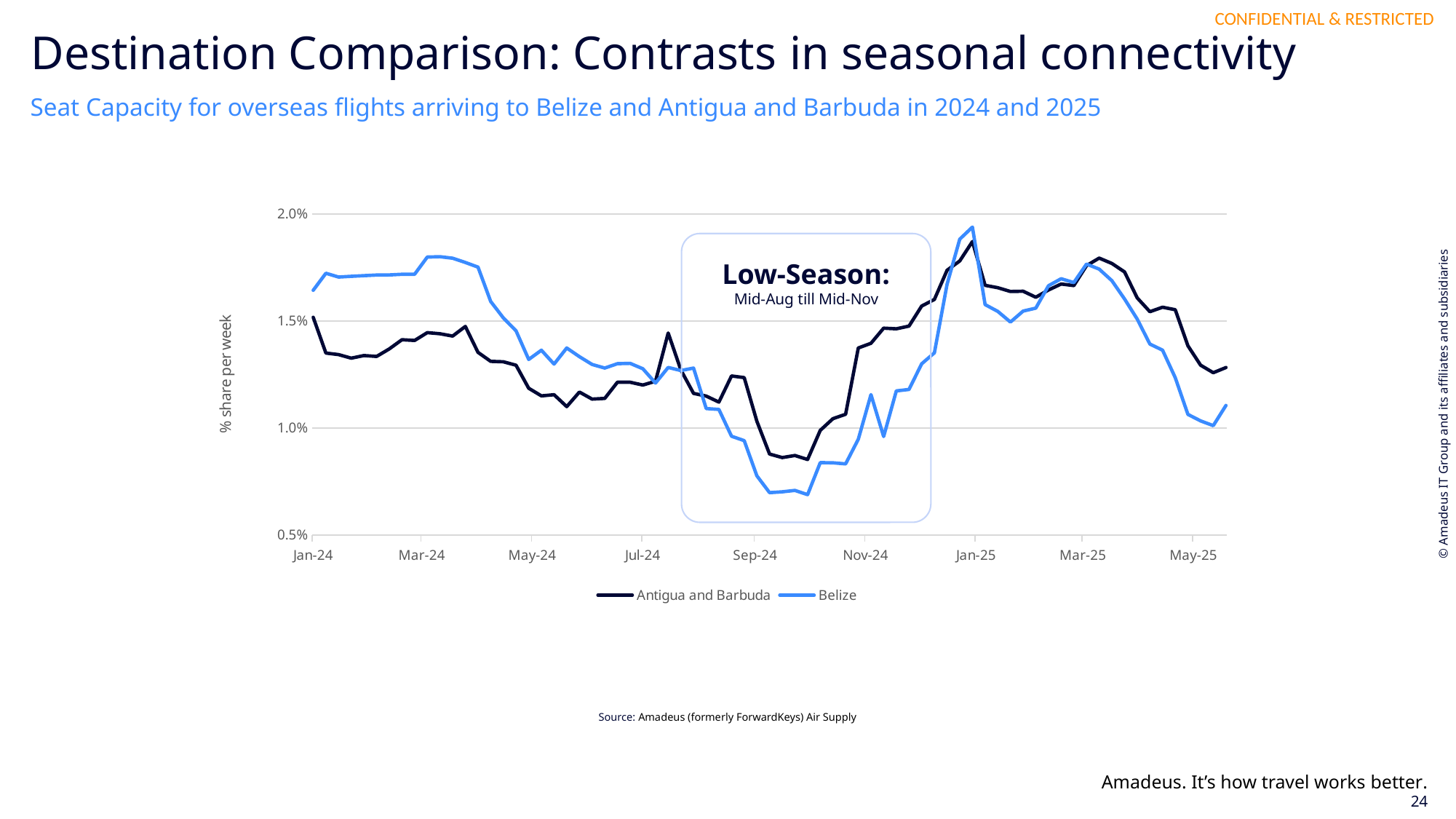
What kind of chart is shown on the slide? Line chart Is the value for Belize at Jan-24 greater or less than 1.5%? greater Does the Belize line rise or fall between Mar-24 and Sep-24? Fall Is the value for Belize around Sep-24 greater or less than 1.0%? less Which series reaches the lowest point on the chart? Belize At Mar-24, which series has the higher value, Antigua and Barbuda or Belize? Belize At Nov-24, which series has the higher value, Antigua and Barbuda or Belize? Antigua and Barbuda How many series does the legend list? 2 Is the value for Antigua and Barbuda at May-25 greater or less than 1.5%? less Which two series are listed in the chart legend? Antigua and Barbuda; Belize What period does the annotation box on the chart label as the Low-Season? Mid-Aug till Mid-Nov